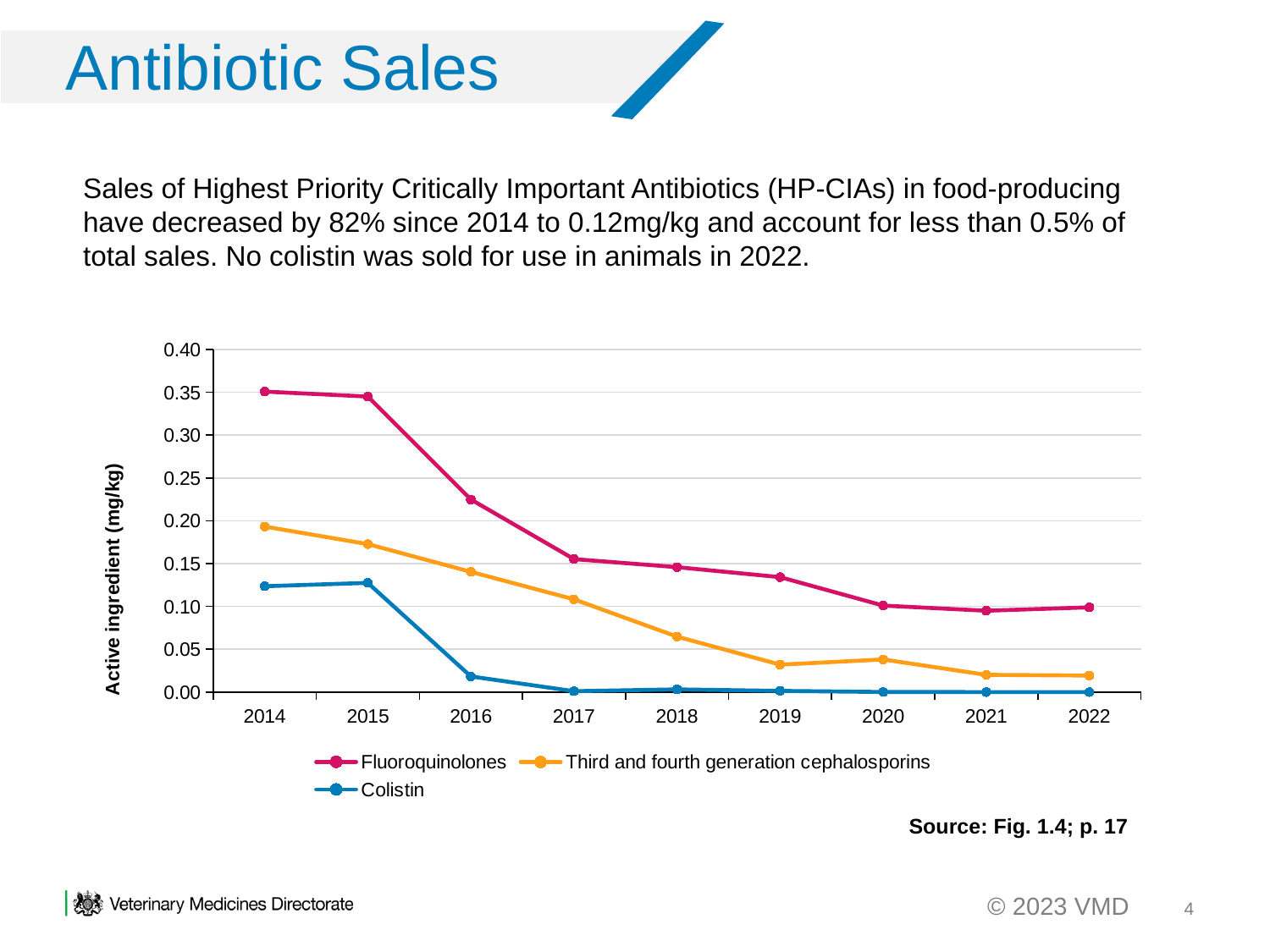
What kind of chart is shown on the slide? Line chart Do the Fluoroquinolones values generally rise or fall from 2014 to 2022? Fall Which series has the lowest value in 2022? Colistin What is the label on the y axis? Active ingredient (mg/kg) How many years are plotted along the x axis? 9 Is the value for Fluoroquinolones in 2014 greater or less than 0.30? greater How many series does the legend list? 3 In which year is the Fluoroquinolones value highest? 2014 Is the value for Third and fourth generation cephalosporins in 2019 greater or less than 0.05? less Which series has the highest value in 2014? Fluoroquinolones Is the value for Colistin in 2015 greater or less than 0.10? greater Which is larger in 2016: Third and fourth generation cephalosporins or Colistin? Third and fourth generation cephalosporins